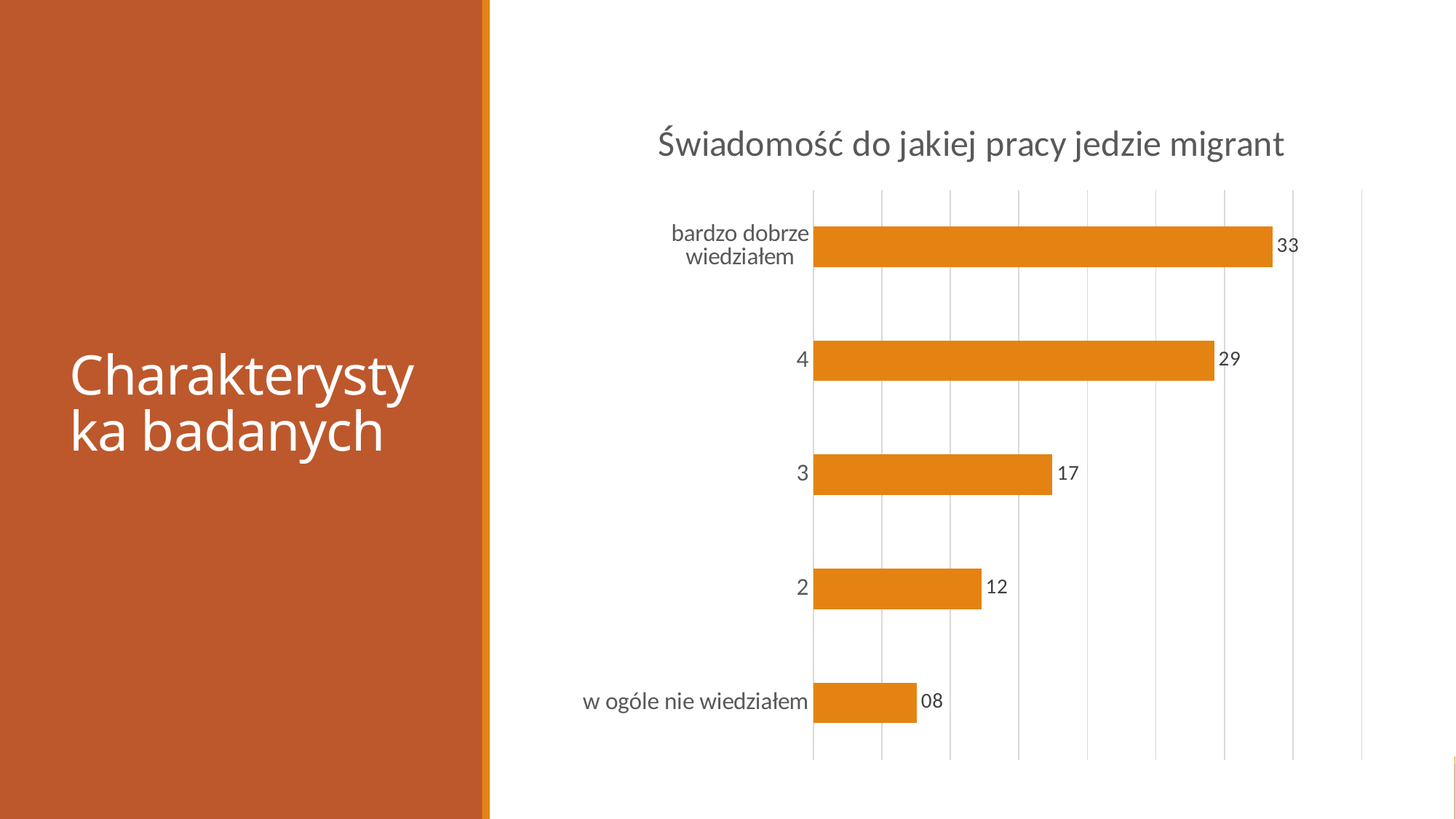
What is the value for category "4"? 29 What is the value for category "3"? 17 Which category has the highest value? bardzo dobrze wiedziałem What is the value for category "2"? 12 What kind of chart is shown on the slide? bar chart How many categories are shown in the chart? 5 What is the value for "bardzo dobrze wiedziałem"? 33 Which is larger, the value for category "3" or category "2"? 3 What is the difference between the values for "bardzo dobrze wiedziałem" and "w ogóle nie wiedziałem"? 25 Which category has the lowest value? w ogóle nie wiedziałem What is the title of the chart? Świadomość do jakiej pracy jedzie migrant What is the value for "w ogóle nie wiedziałem"? 08